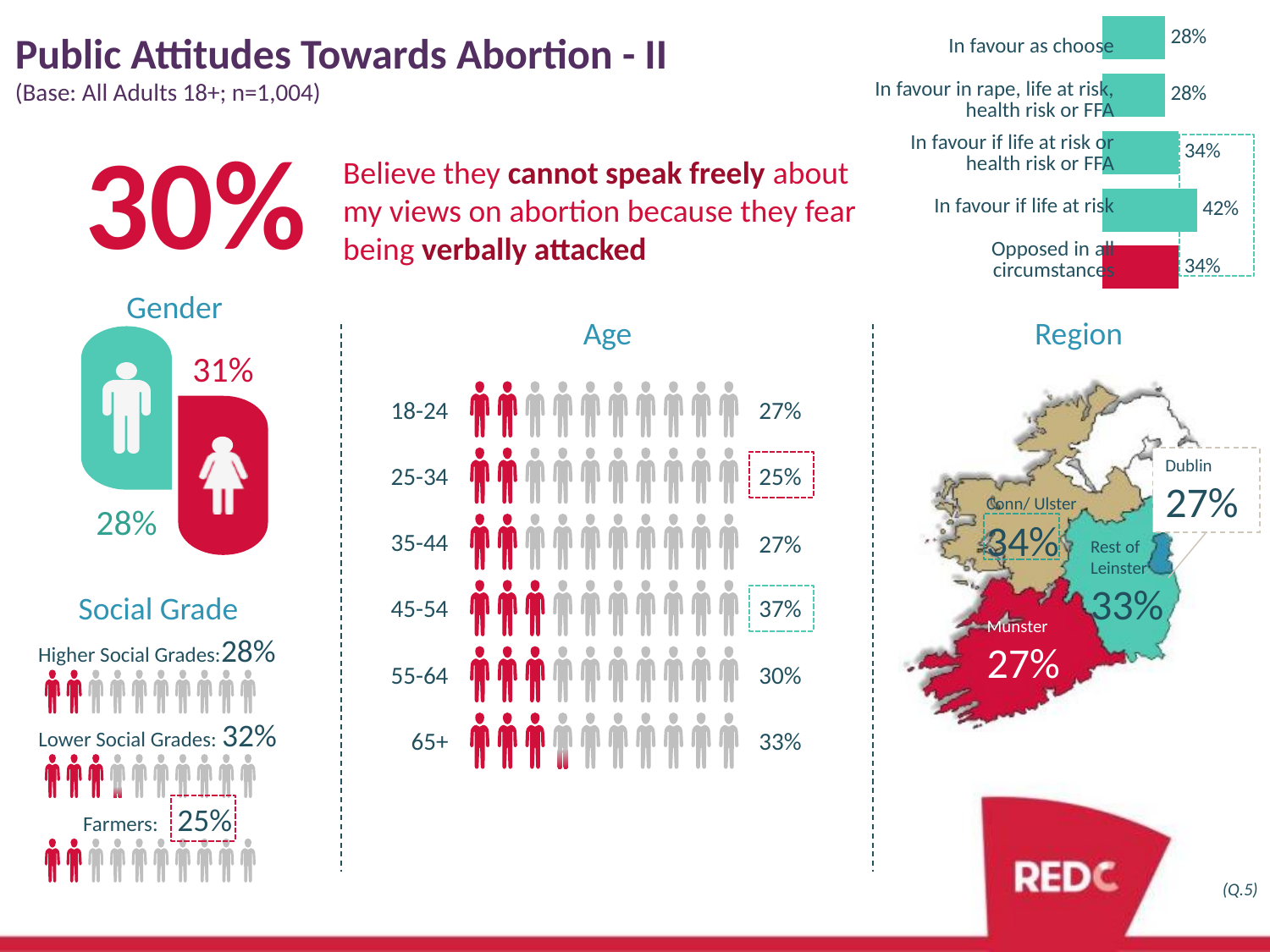
In the bar chart at the top right, what is the difference between 'In favour if life at risk' and 'In favour as choose'? 14 percentage points In the bar chart at the top right, what is the value for 'In favour if life at risk'? 42% In the Age chart, how many age groups are shown? 6 In the Age chart, which age group has the lowest value? 25-34 In the bar chart at the top right, which is larger: 'In favour if life at risk or health risk or FFA' or 'In favour in rape, life at risk, health risk or FFA'? In favour if life at risk or health risk or FFA In the bar chart at the top right, what is the value for 'Opposed in all circumstances'? 34% In the bar chart at the top right, which category is shown with a red bar rather than a teal one? Opposed in all circumstances In the bar chart at the top right, how many categories are shown? 5 In the bar chart at the top right, what is the value for 'In favour as choose'? 28% In the Age chart, what is the value for the 45-54 age group? 37% What kind of chart is shown at the top right of the slide? Bar chart In the bar chart at the top right, which category has the highest value? In favour if life at risk